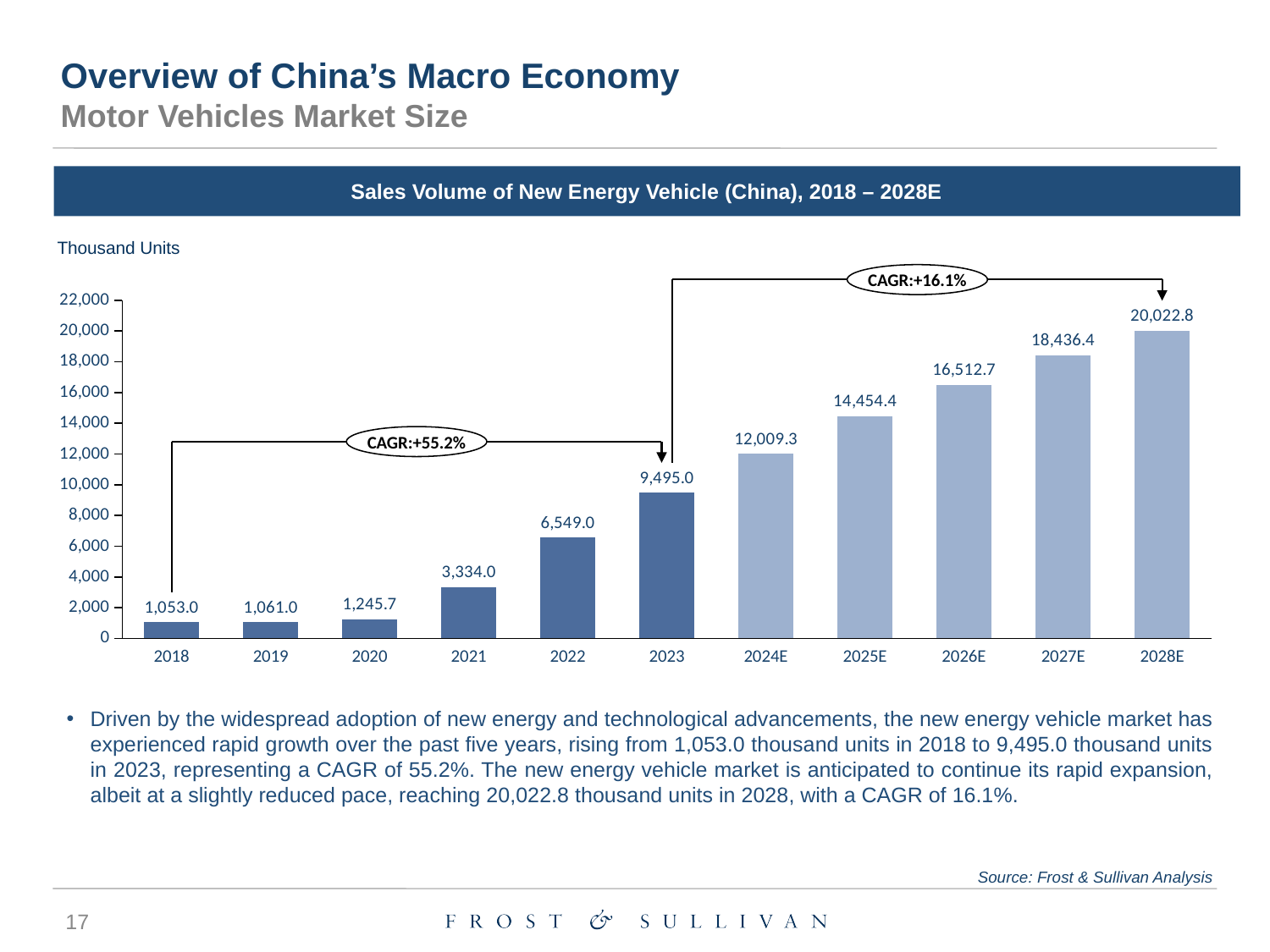
What is the difference in sales volume between 2023 and 2022? 2,946.0 What CAGR is shown for the period from 2018 to 2023? +55.2% What is the sales volume of new energy vehicles in China for 2021? 3,334.0 Is the sales volume for 2025E greater or less than 14,000? greater How many years are shown on the x axis of the chart? 11 What kind of chart is used to show the sales volume of new energy vehicles? bar chart What unit is used for the values in the chart? Thousand Units Which year has the lowest sales volume of new energy vehicles in the chart? 2018 Which year has a larger sales volume, 2020 or 2021? 2021 What is the sales volume of new energy vehicles in China for 2026E? 16,512.7 Which year has the highest sales volume of new energy vehicles in the chart? 2028E Do the sales volumes rise or fall from 2018 to 2028E? rise